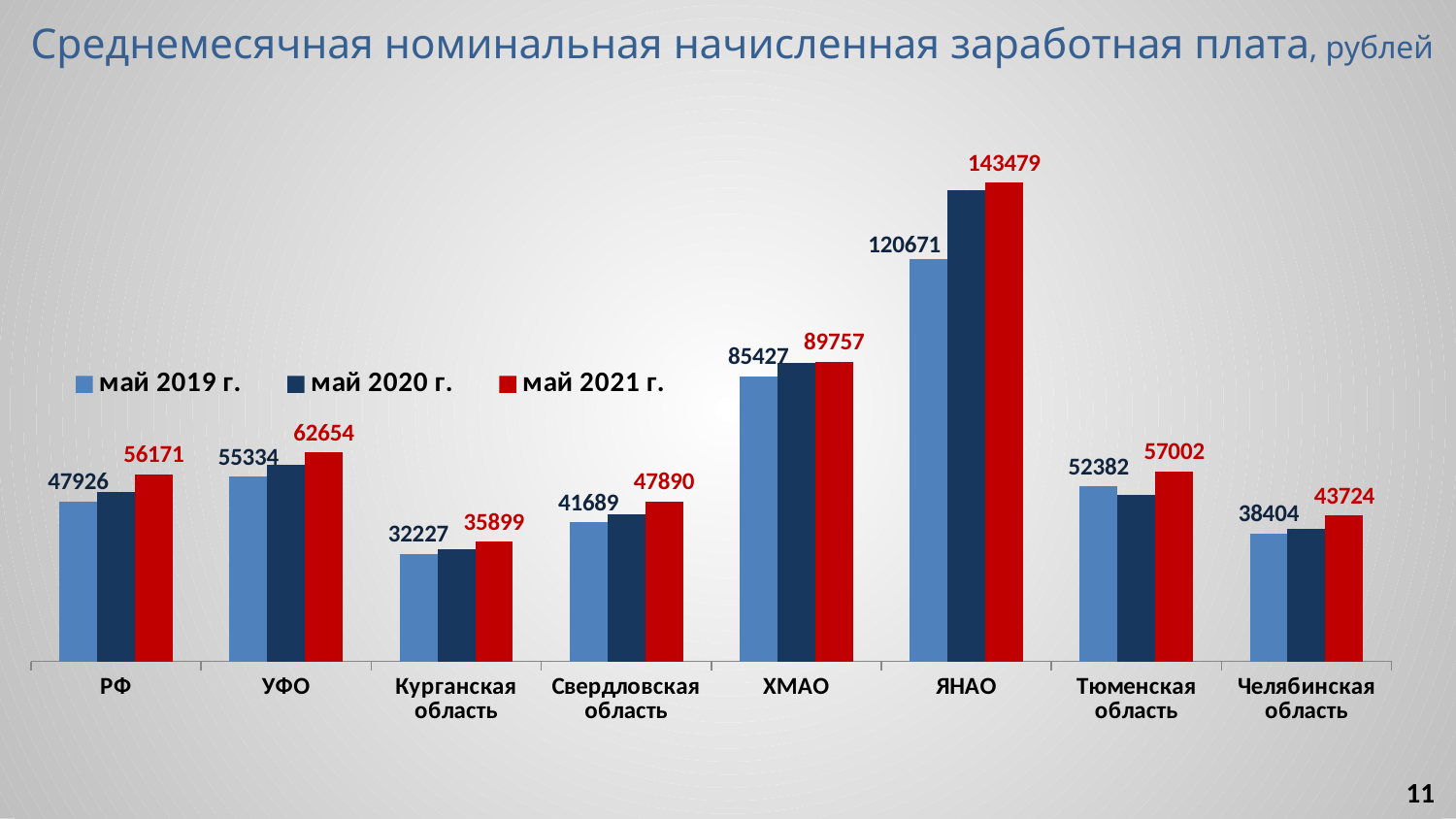
What is the difference between the май 2021 г. and май 2019 г. values for ЯНАО? 22808 What is the value for Тюменская область in май 2019 г.? 52382 Which series is shown in red in the legend? май 2021 г. What is the value for РФ in май 2019 г.? 47926 Which category has the lowest value in май 2019 г.? Курганская область What is the value for ЯНАО in май 2021 г.? 143479 How many categories are shown on the x axis? 8 What type of chart is shown on the slide? bar chart How many series does the legend list? 3 What is the value for Курганская область in май 2021 г.? 35899 Which is larger: the май 2021 г. value for УФО or the май 2021 г. value for Тюменская область? УФО Which category has the highest value in май 2021 г.? ЯНАО